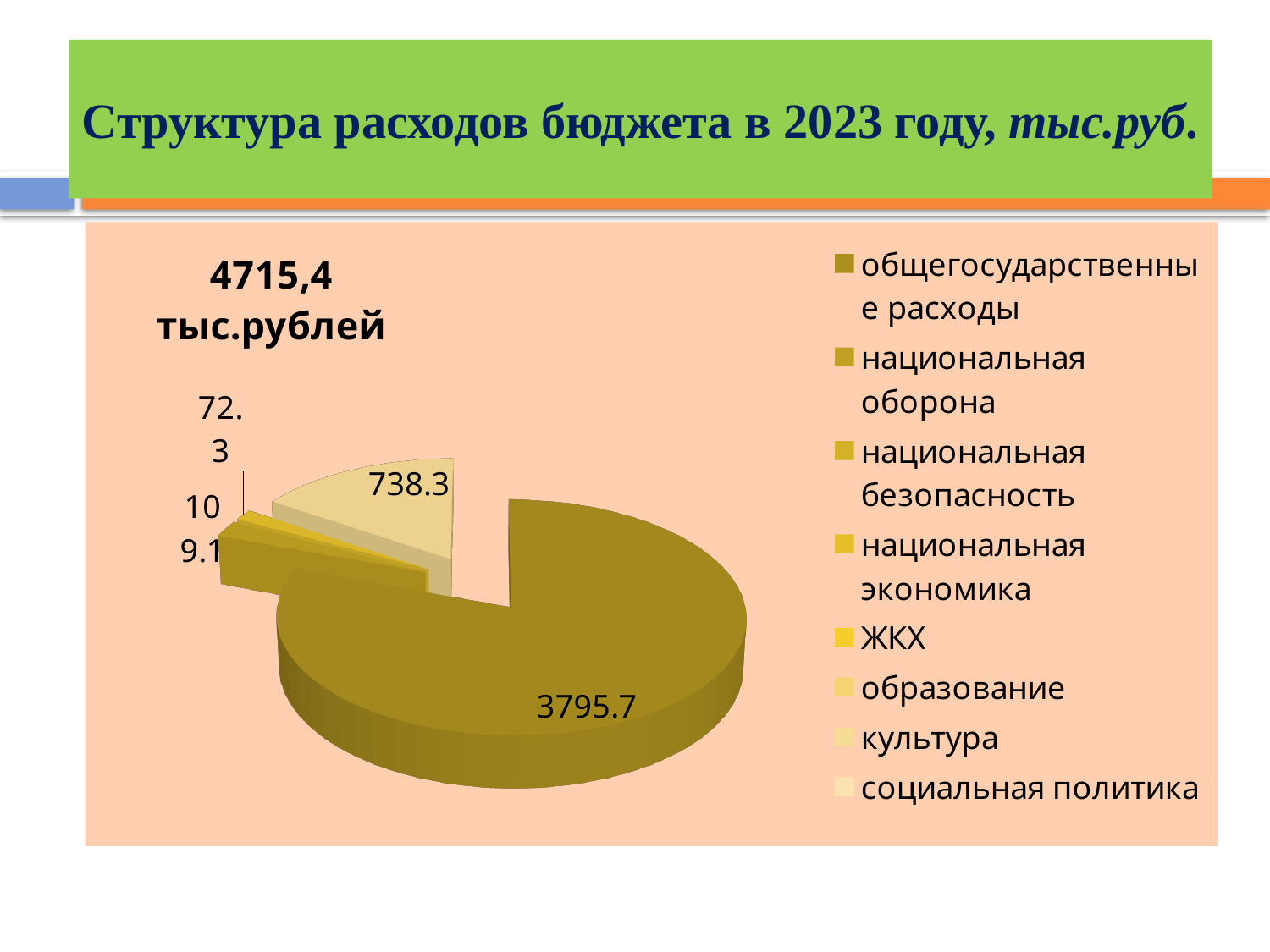
Does the largest slice of the pie chart cover more or less than half of the pie? more What is the difference between the slice labelled 3795.7 and the slice labelled 738.3? 3057.4 What is the value printed on the largest slice of the pie chart? 3795.7 Which is larger, the slice labelled 3795.7 or the slice labelled 738.3? 3795.7 How many categories does the legend of the pie chart list? 8 Which category has the largest slice in the pie chart? общегосударственные расходы What total amount is shown in the chart title above the pie? 4715,4 тыс.рублей What kind of chart is shown on the slide? pie chart What is the value printed on the second-largest slice of the pie chart? 738.3 What is the highest value printed on any slice of the pie chart? 3795.7 What is the last entry in the pie chart's legend? социальная политика